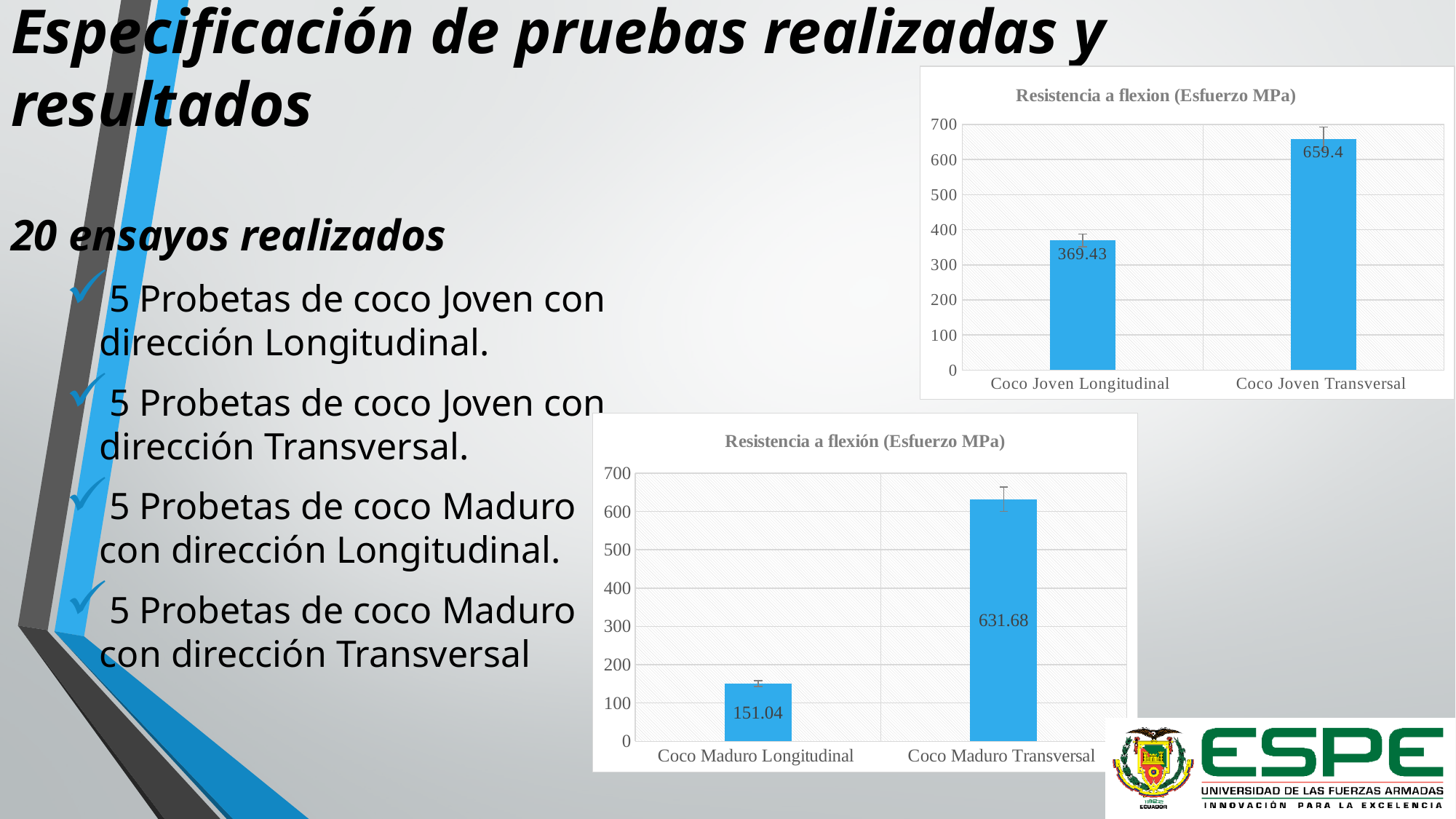
In the bottom chart, what is the difference between the values for Coco Maduro Transversal and Coco Maduro Longitudinal? 480.64 In the bottom chart, what is the value for Coco Maduro Longitudinal? 151.04 In the top-right chart, what is the difference between the values for Coco Joven Transversal and Coco Joven Longitudinal? 289.97 What is the title of the top-right chart? Resistencia a flexion (Esfuerzo MPa) How many categories are shown in the top-right chart? 2 In the bottom chart, is the value for Coco Maduro Longitudinal greater or less than 200? less In the top-right chart, what is the value for Coco Joven Longitudinal? 369.43 In the top-right chart, which category has the highest value? Coco Joven Transversal In the top-right chart, what is the value for Coco Joven Transversal? 659.4 In the bottom chart, which category has the lowest value? Coco Maduro Longitudinal What kind of chart is the bottom chart? bar chart In the bottom chart, what is the value for Coco Maduro Transversal? 631.68